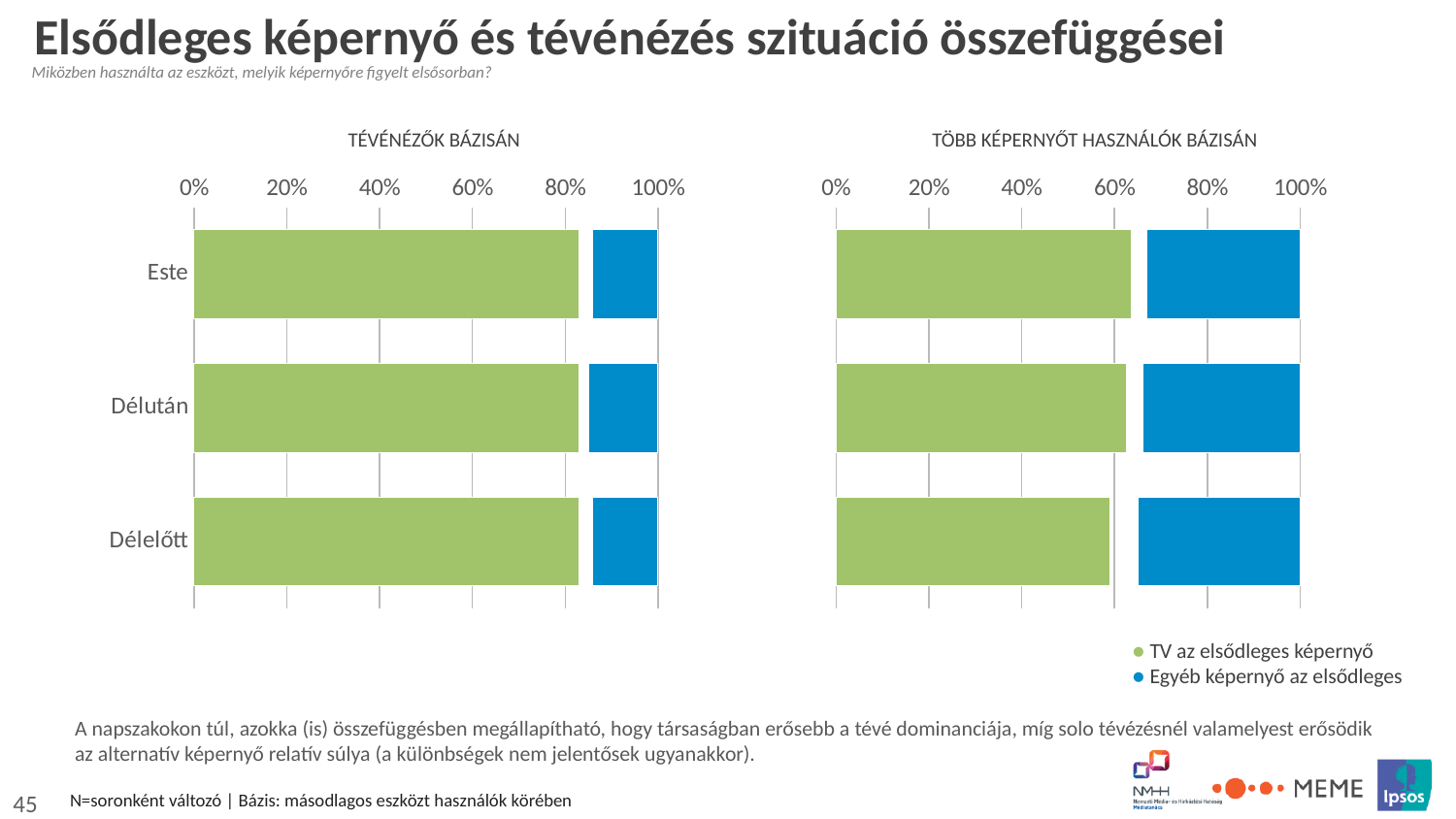
How many categories are shown on the left chart 'TÉVÉNÉZŐK BÁZISÁN'? 3 In the right chart 'TÖBB KÉPERNYŐT HASZNÁLÓK BÁZISÁN', is the value of 'TV az elsődleges képernyő' for Délelőtt greater or less than 40%? greater What is the title of the right chart? TÖBB KÉPERNYŐT HASZNÁLÓK BÁZISÁN Which colour represents 'TV az elsődleges képernyő' in the legend? Green How many series does the legend list for the charts on the slide? 2 In the right chart 'TÖBB KÉPERNYŐT HASZNÁLÓK BÁZISÁN', which category has the lowest 'TV az elsődleges képernyő' value? Délelőtt In the left chart 'TÉVÉNÉZŐK BÁZISÁN', is the value of 'Egyéb képernyő az elsődleges' for Délután greater or less than 40%? less In the right chart 'TÖBB KÉPERNYŐT HASZNÁLÓK BÁZISÁN', which is larger for Délelőtt: 'TV az elsődleges képernyő' or 'Egyéb képernyő az elsődleges'? TV az elsődleges képernyő What kind of chart is the left chart titled 'TÉVÉNÉZŐK BÁZISÁN'? Stacked bar chart Which is larger: the 'TV az elsődleges képernyő' value for Este in the left chart 'TÉVÉNÉZŐK BÁZISÁN' or for Este in the right chart 'TÖBB KÉPERNYŐT HASZNÁLÓK BÁZISÁN'? Este in the left chart (TÉVÉNÉZŐK BÁZISÁN) In the left chart 'TÉVÉNÉZŐK BÁZISÁN', is the value of 'TV az elsődleges képernyő' for Este greater or less than 60%? greater